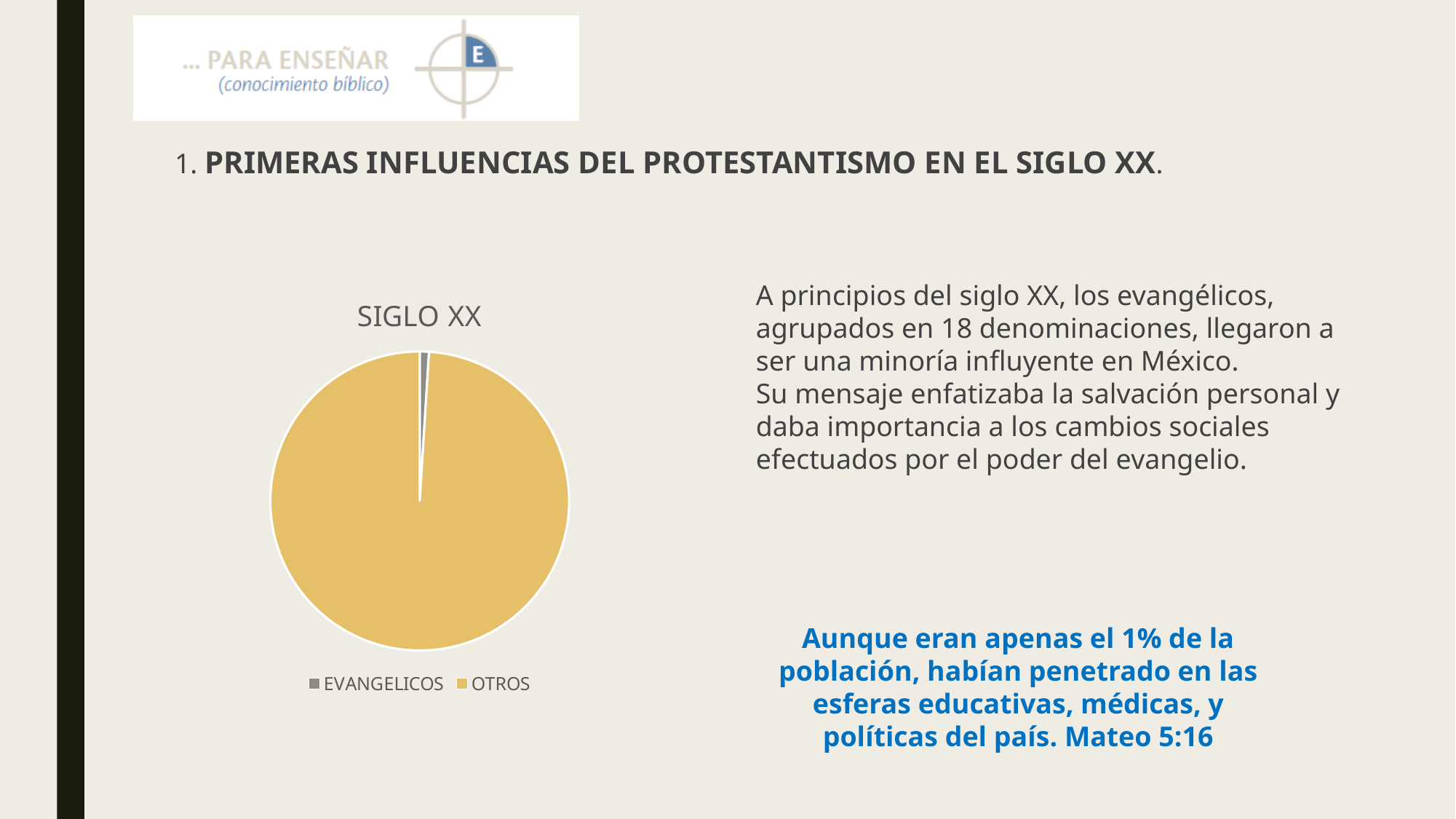
What colour is the OTROS slice in the pie chart? gold What is the title of the chart? SIGLO XX Which slice is larger, EVANGELICOS or OTROS? OTROS Which category has the largest slice of the pie? OTROS What kind of chart is shown on the slide? pie chart Which category has the smallest slice of the pie? EVANGELICOS How many slices does the pie chart have? 2 How many entries does the chart legend list? 2